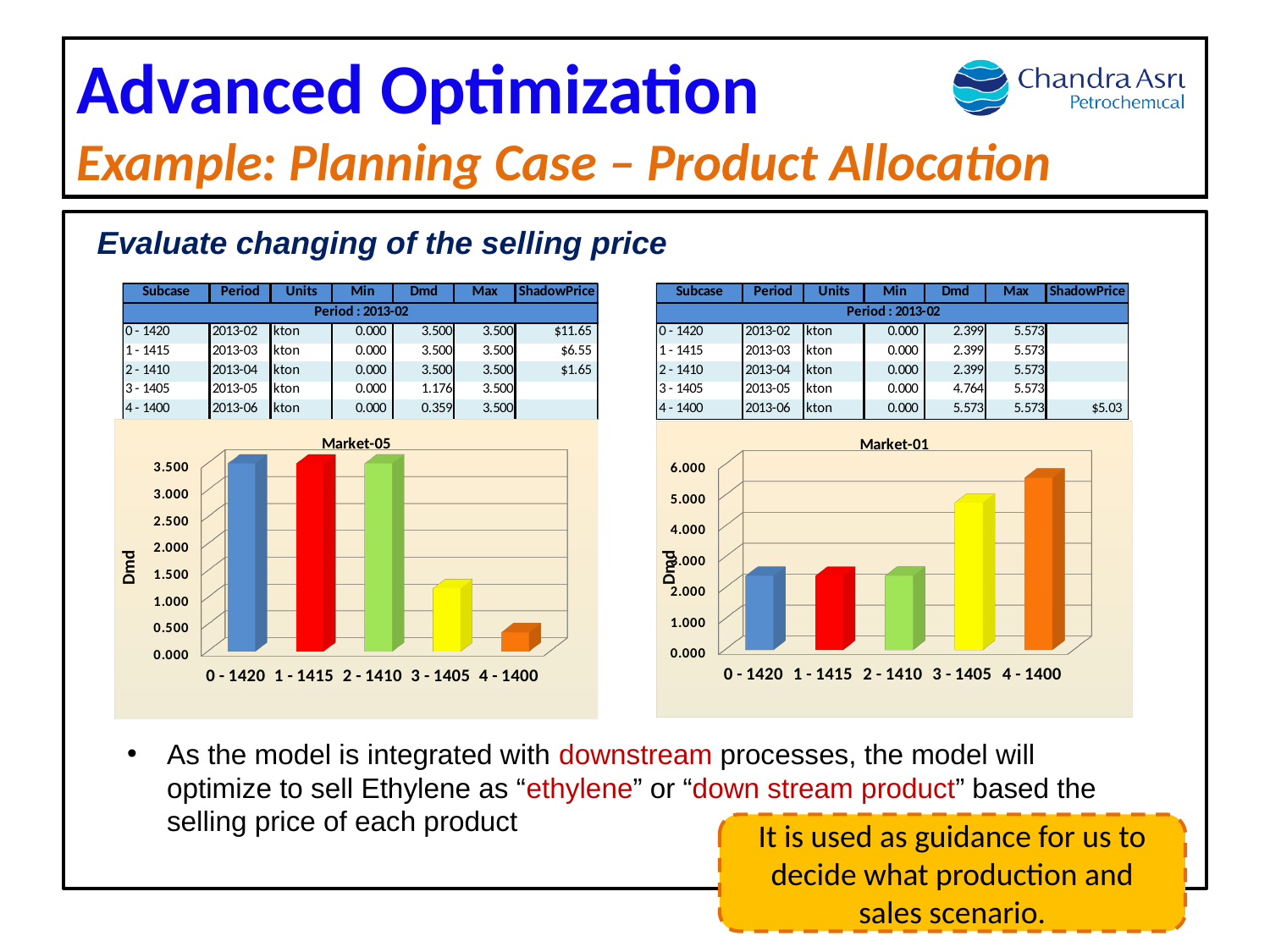
In the Market-01 chart, is the value for 0 - 1420 greater or less than 3.000? less In the Market-05 chart, what is the Dmd value for 0 - 1420? 3.500 In the Market-05 chart, is the value for 3 - 1405 greater or less than 1.500? less In the Market-01 chart, is the value for 3 - 1405 greater or less than 4.000? greater How many categories are shown on the x axis of the Market-05 chart? 5 In the Market-01 chart, do the values generally rise or fall from left to right along the x axis? rise What is the label on the y axis of the Market-05 chart? Dmd In the Market-05 chart, which is larger, the value for 3 - 1405 or the value for 4 - 1400? 3 - 1405 In the Market-05 chart, which category has the lowest Dmd value? 4 - 1400 In the Market-01 chart, what is the Dmd value for 4 - 1400 as given in the table above it? 5.573 What kind of chart is the Market-05 chart? bar chart In the Market-01 chart, which category has the highest Dmd value? 4 - 1400